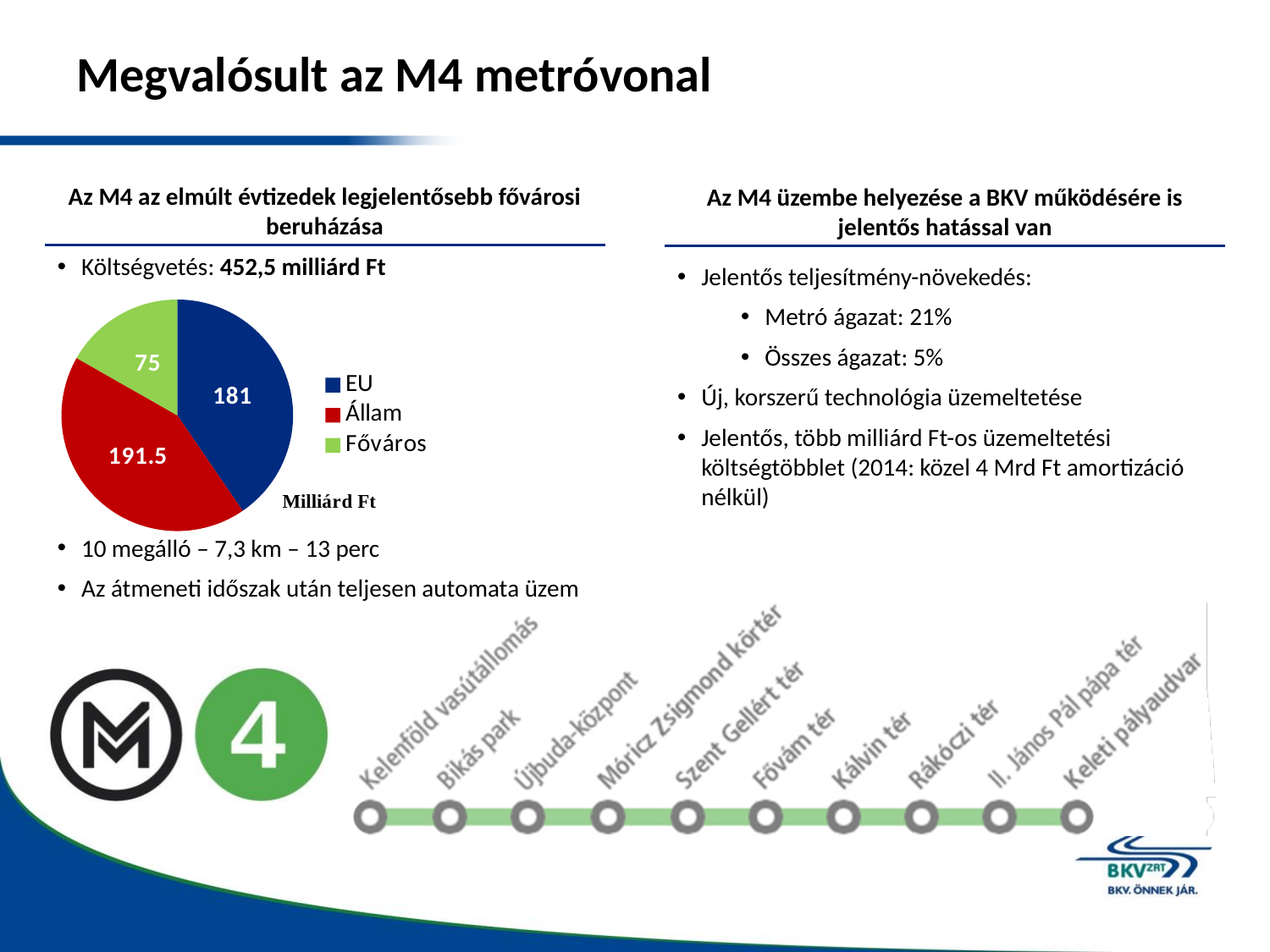
What unit is indicated below the pie chart? Milliárd Ft How many slices does the pie chart have? 3 Which category has the largest slice in the pie chart? Állam What is the difference between the EU and Főváros values in the pie chart? 106 Which category has the smallest slice in the pie chart? Főváros How many entries does the pie chart legend list? 3 What is the difference between the Állam and EU values in the pie chart? 10.5 What is the value for Főváros in the pie chart? 75 Which is larger in the pie chart, the value for EU or the value for Főváros? EU What is the value for EU in the pie chart? 181 What is the value for Állam in the pie chart? 191.5 What type of chart is shown on the slide? Pie chart